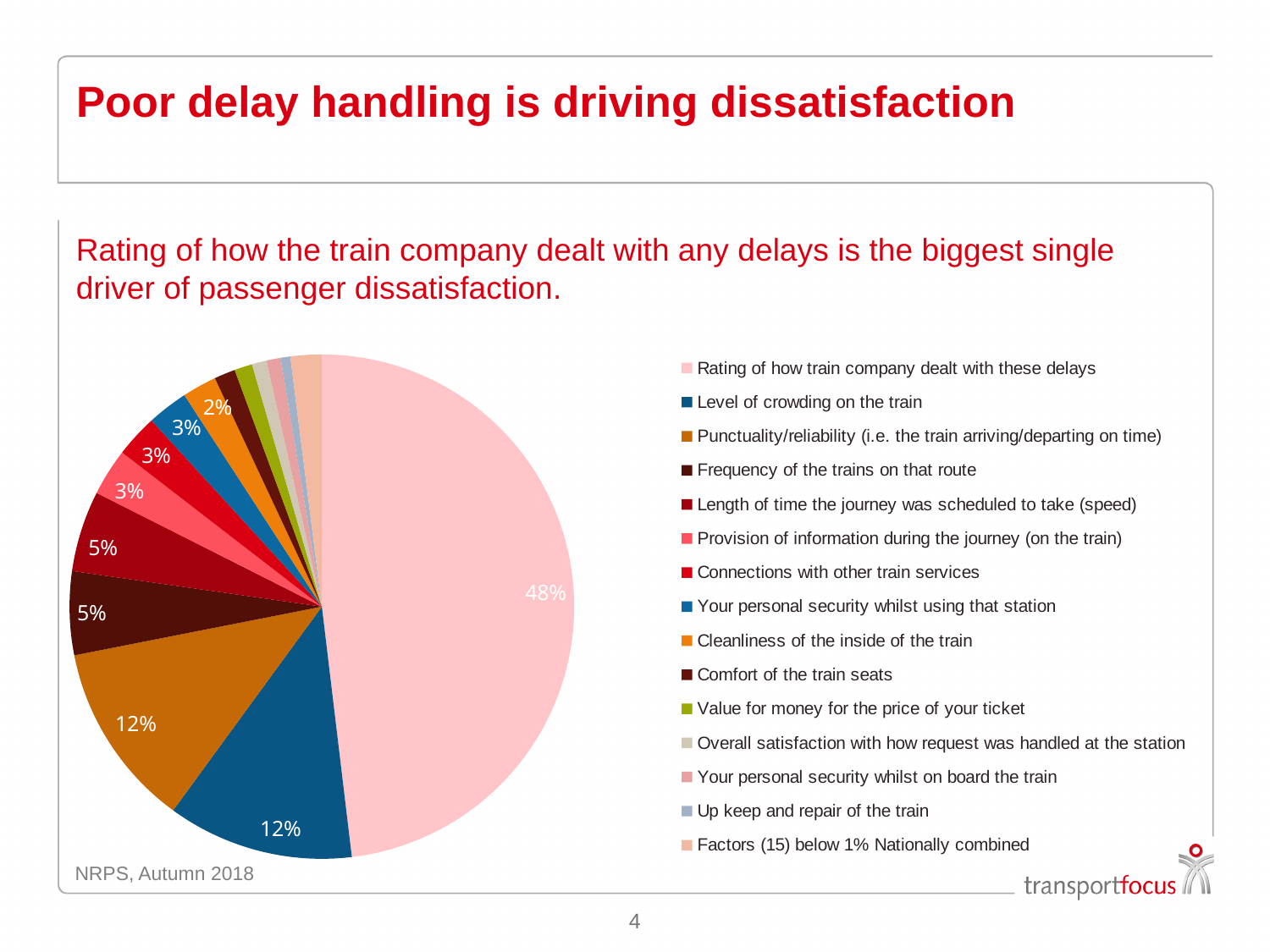
Which factor has the largest slice of the pie? Rating of how train company dealt with these delays How many percentage points larger is the slice for 'Rating of how train company dealt with these delays' than the slice for 'Level of crowding on the train'? 36 percentage points What percentage is shown for 'Cleanliness of the inside of the train'? 2% Which has the larger slice: 'Length of time the journey was scheduled to take (speed)' or 'Connections with other train services'? Length of time the journey was scheduled to take (speed) What type of chart is shown on the slide? Pie chart What percentage is shown for 'Punctuality/reliability (i.e. the train arriving/departing on time)'? 12% What share of the pie does 'Rating of how train company dealt with these delays' account for? 48% How many entries does the legend list? 15 What percentage is shown for 'Frequency of the trains on that route'? 5% What is the combined share of the three largest slices (48%, 12% and 12%)? 72% Which has the larger slice: 'Frequency of the trains on that route' or 'Cleanliness of the inside of the train'? Frequency of the trains on that route What percentage is shown for 'Level of crowding on the train'? 12%